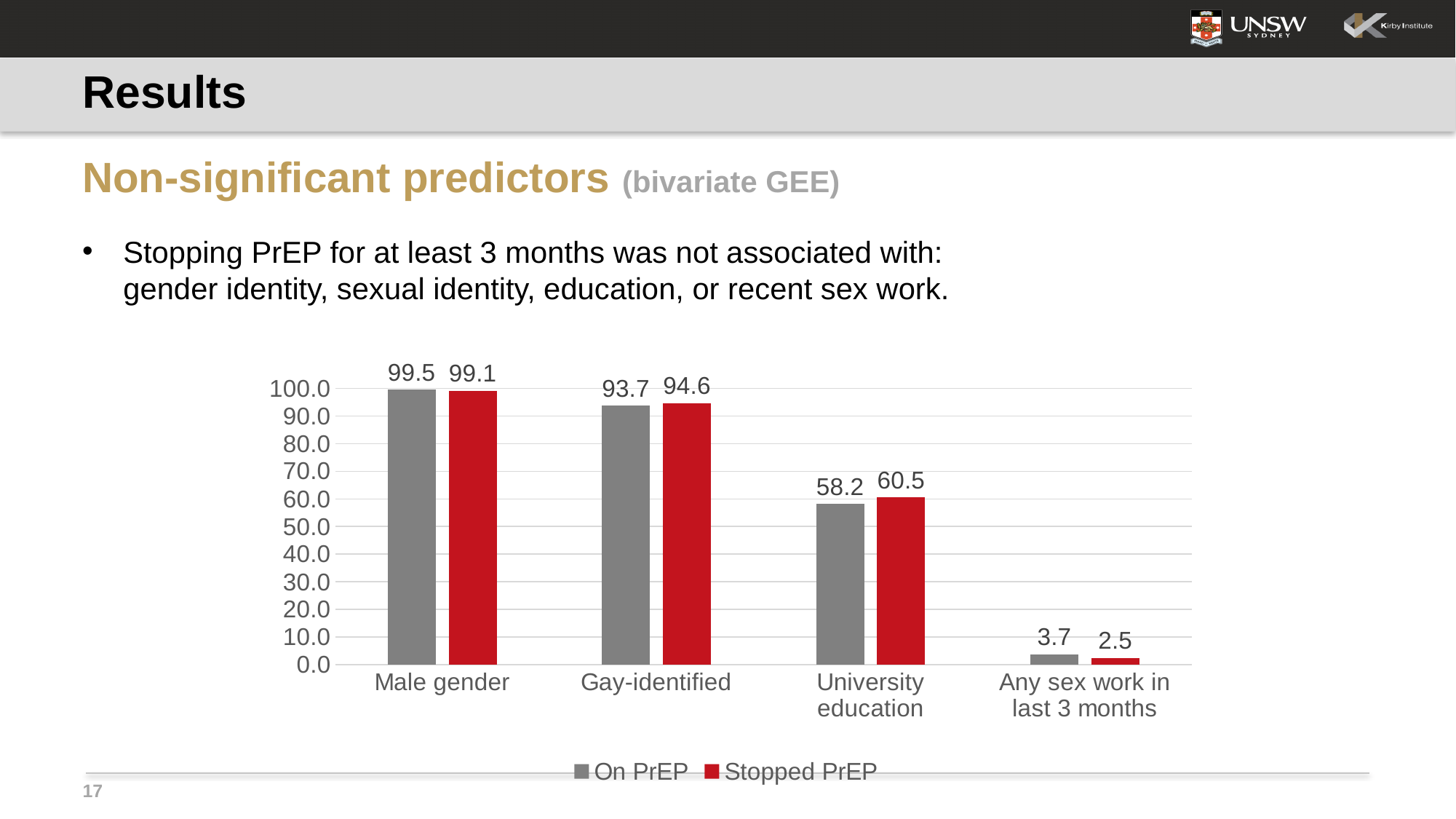
What is the difference between the Stopped PrEP and On PrEP values for University education? 2.3 What is the value for University education in the Stopped PrEP series? 60.5 What colour are the Stopped PrEP bars? Red Which category has the lowest value in the On PrEP series? Any sex work in last 3 months What is the value for Male gender in the On PrEP series? 99.5 How many categories are shown on the x axis of the chart? 4 What is the value for Any sex work in last 3 months in the Stopped PrEP series? 2.5 Which category has the highest value in the Stopped PrEP series? Male gender How many series does the legend list? 2 What is the value for Gay-identified in the On PrEP series? 93.7 For Any sex work in last 3 months, which series has the larger value, On PrEP or Stopped PrEP? On PrEP What kind of chart is shown on the slide? Bar chart